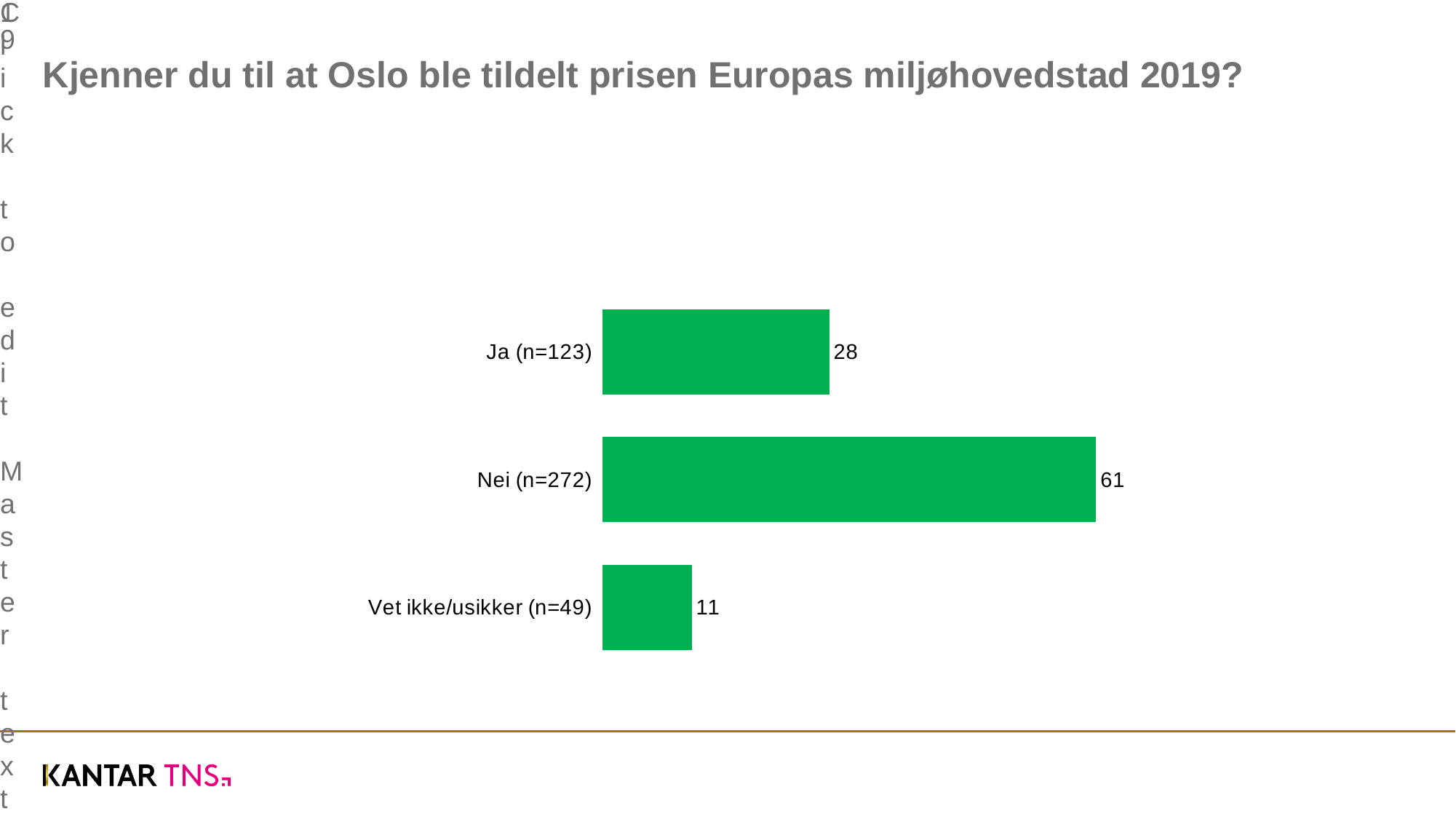
Which category has the lowest value? Vet ikke/usikker (n=49) What is the difference between the values for Nei (n=272) and Ja (n=123)? 33 What is the value for Vet ikke/usikker (n=49)? 11 What is the total of the three values shown in the chart? 100 What is the value for Ja (n=123)? 28 How many categories are shown in the chart? 3 What is the difference between the values for Ja (n=123) and Vet ikke/usikker (n=49)? 17 What is the value for Nei (n=272)? 61 What colour are the bars in the chart? green What kind of chart is shown on the slide? bar chart Which is larger, the value for Ja (n=123) or the value for Vet ikke/usikker (n=49)? Ja (n=123) Which category has the highest value? Nei (n=272)